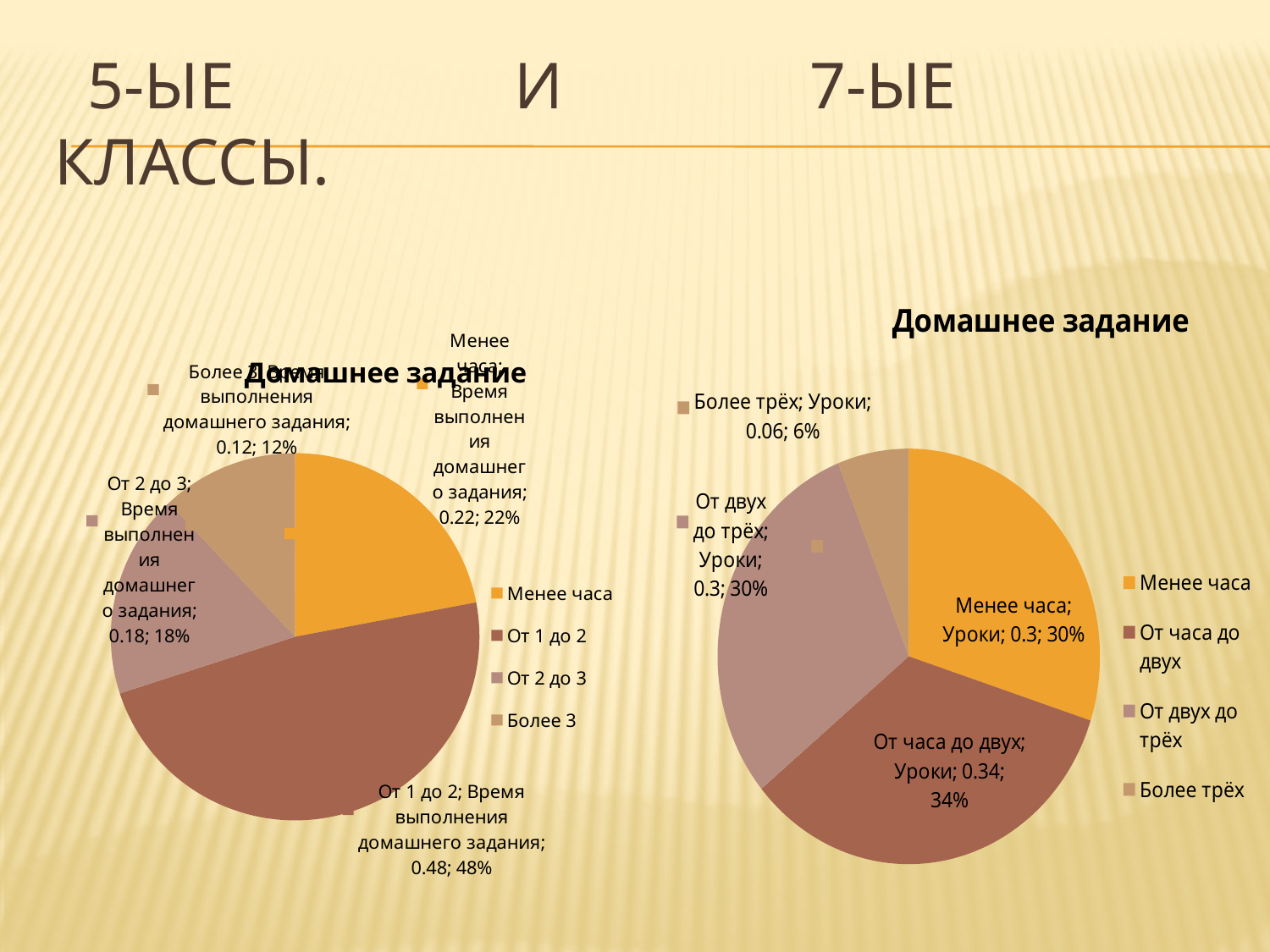
On the left pie chart, what is the difference in percentage points between 'От 1 до 2' and 'От 2 до 3'? 30 On the right pie chart, which category has the smallest slice? Более трёх On the right pie chart, which category has the largest slice? От часа до двух On the right pie chart, what share is shown for 'От часа до двух'? 34% On the right pie chart, what share is shown for 'Более трёх'? 6% On the left pie chart, what share is shown for the category 'От 1 до 2'? 48% On the left pie chart, which category has the largest slice? От 1 до 2 How many categories does the legend of the right pie chart list? 4 Which is larger on the right pie chart: 'Менее часа' or 'Более трёх'? Менее часа On the left pie chart, which category has the smallest slice? Более 3 What type of chart is shown on the left side of the slide? Pie chart